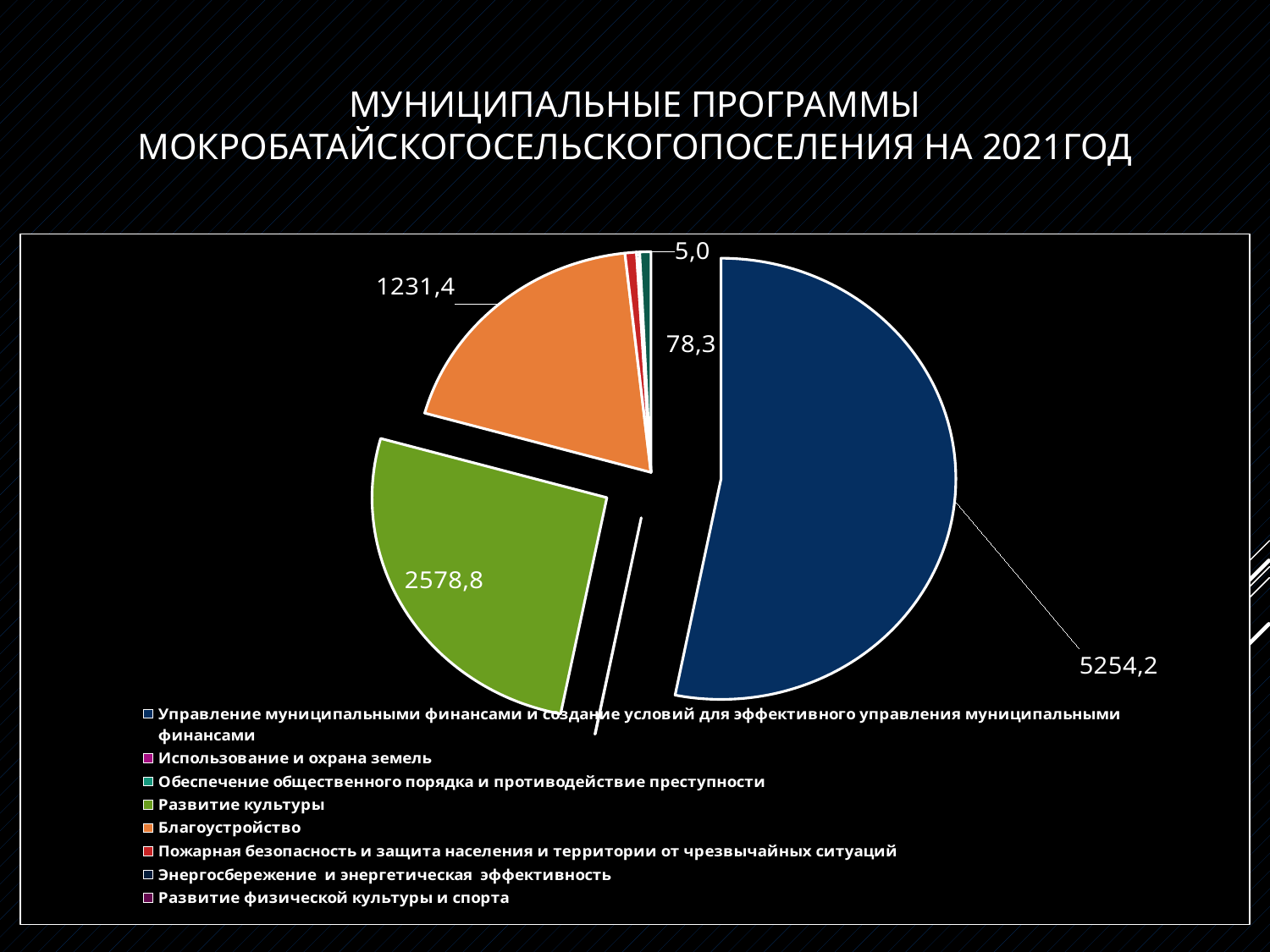
What is the difference between the values for Развитие культуры and Благоустройство? 1347,4 What is the value for Благоустройство? 1231,4 What is the value for Управление муниципальными финансами и создание условий для эффективного управления муниципальными финансами? 5254,2 What is the smallest value labelled on the pie chart? 5,0 How many categories does the legend list? 8 Which category has the largest slice of the pie? Управление муниципальными финансами и создание условий для эффективного управления муниципальными финансами What is the value for Развитие культуры? 2578,8 What kind of chart is shown on the slide? pie chart What colour is the slice for Развитие культуры? green What is the difference between the values for Управление муниципальными финансами и создание условий для эффективного управления муниципальными финансами and Развитие культуры? 2675,4 What is the title of the slide? МУНИЦИПАЛЬНЫЕ ПРОГРАММЫ МОКРОБАТАЙСКОГОСЕЛЬСКОГОПОСЕЛЕНИЯ НА 2021ГОД Which is larger, the value for Развитие культуры or the value for Благоустройство? Развитие культуры